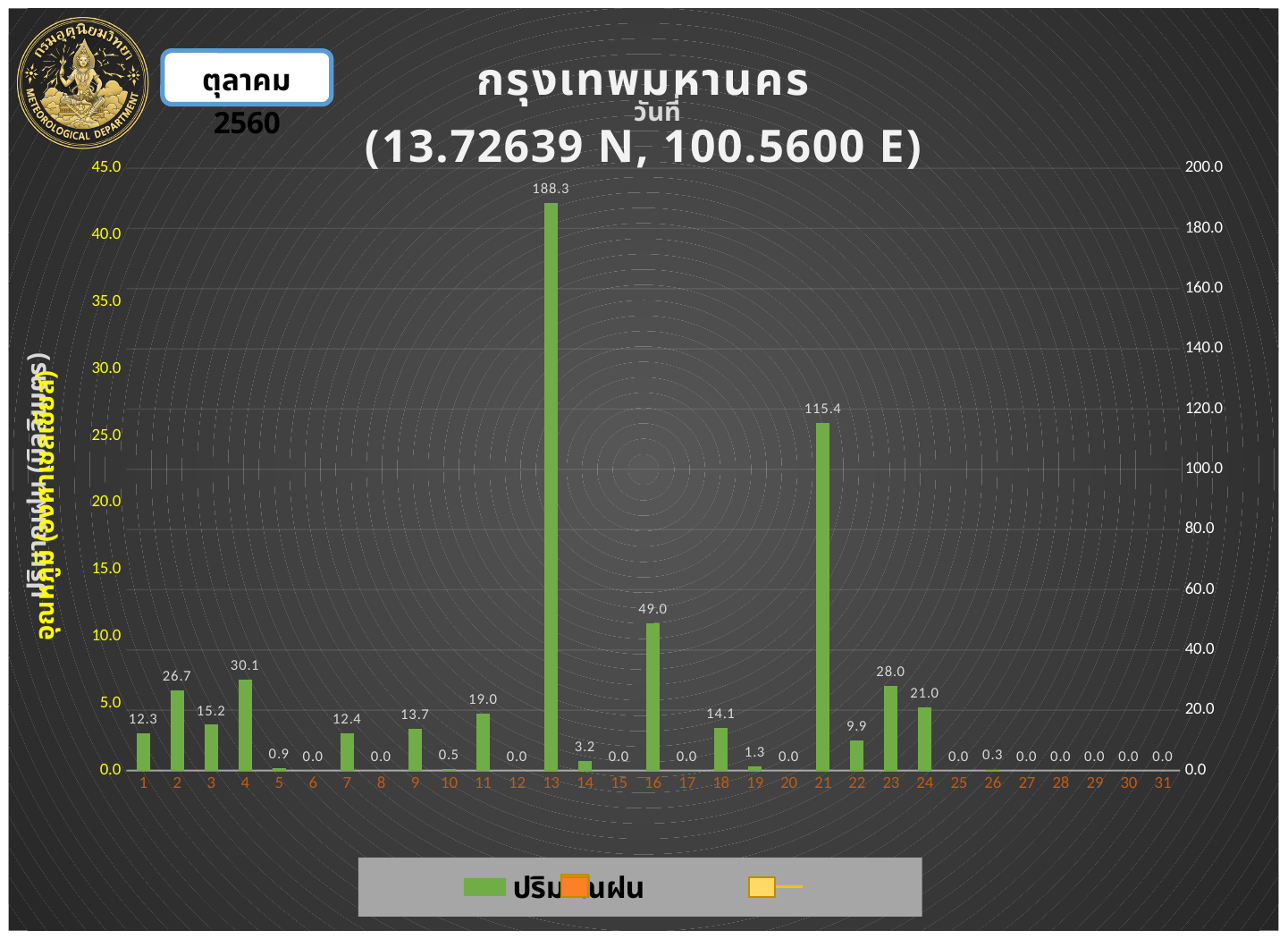
What is the value labelled on the bar for day 4? 30.1 Is the value for day 16 greater or less than 40.0 on the right-hand axis? greater How many days are shown along the x axis? 31 Which day has the highest rainfall value? 13 What coordinates are given in the chart title? 13.72639 N, 100.5600 E What is the difference between the values for day 23 and day 24? 7.0 What is the difference between the values for day 13 and day 21? 72.9 What is the value labelled on the bar for day 16? 49.0 What is the rainfall value shown for day 21? 115.4 What is the rainfall value shown for day 13? 188.3 Which has the larger value, day 2 or day 4? day 4 What kind of chart is shown on the slide? bar chart